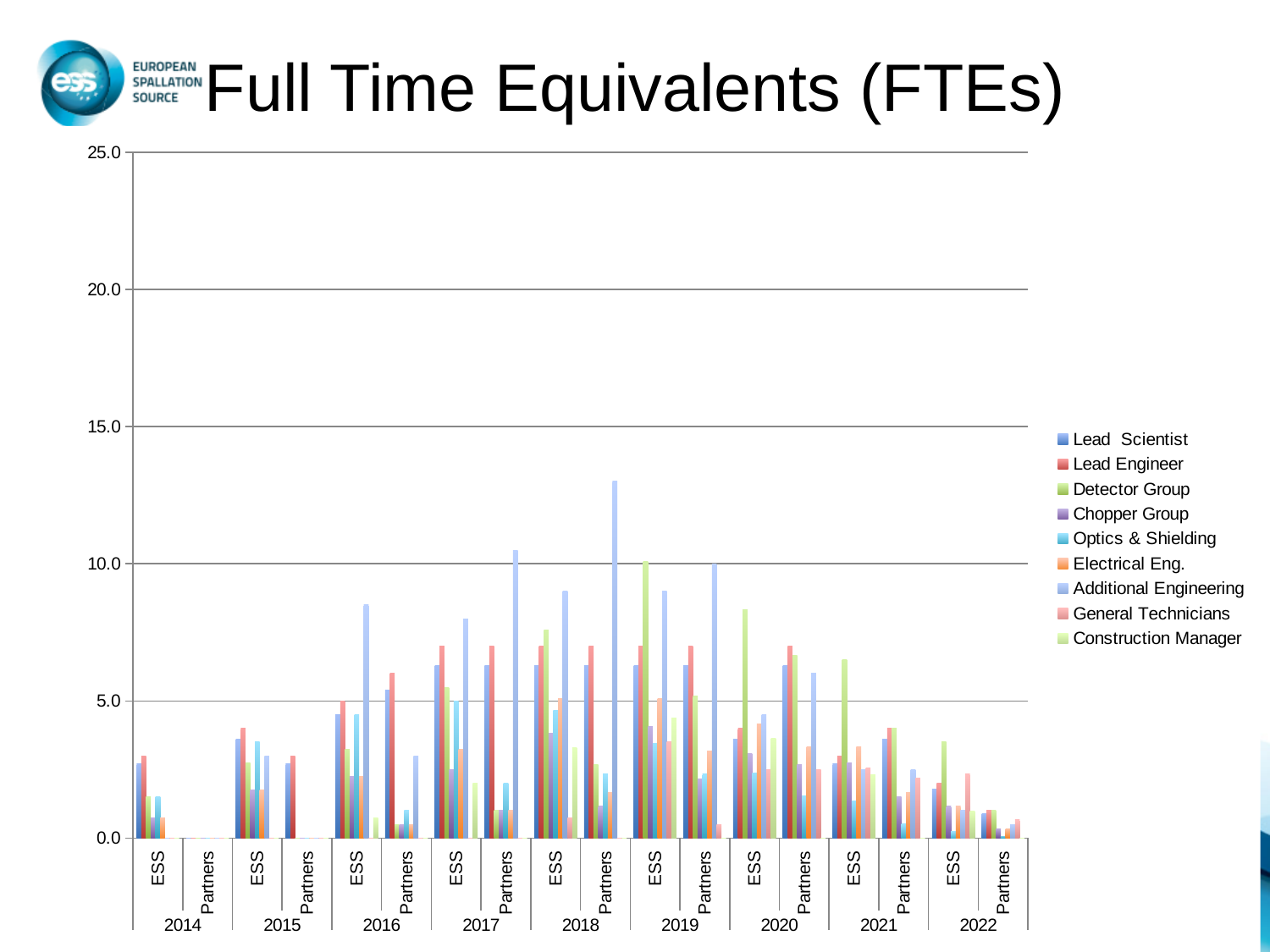
Is the Lead Scientist value for 2014 ESS greater or less than 5.0? less In which year and group does the tallest bar of the chart appear? 2018 Partners How many series does the legend list? 9 How many years are shown along the x axis? 9 Do the Lead Scientist values for ESS rise or fall from 2019 to 2022? fall What is the title of the chart? Full Time Equivalents (FTEs) For 2018 Partners, which is larger: Additional Engineering or Lead Engineer? Additional Engineering Is the Additional Engineering value for 2016 ESS greater or less than 10.0? less What kind of chart is shown on the slide? bar chart Is the Additional Engineering value for 2018 Partners greater or less than 10.0? greater Which series has the tallest bar in the whole chart? Additional Engineering